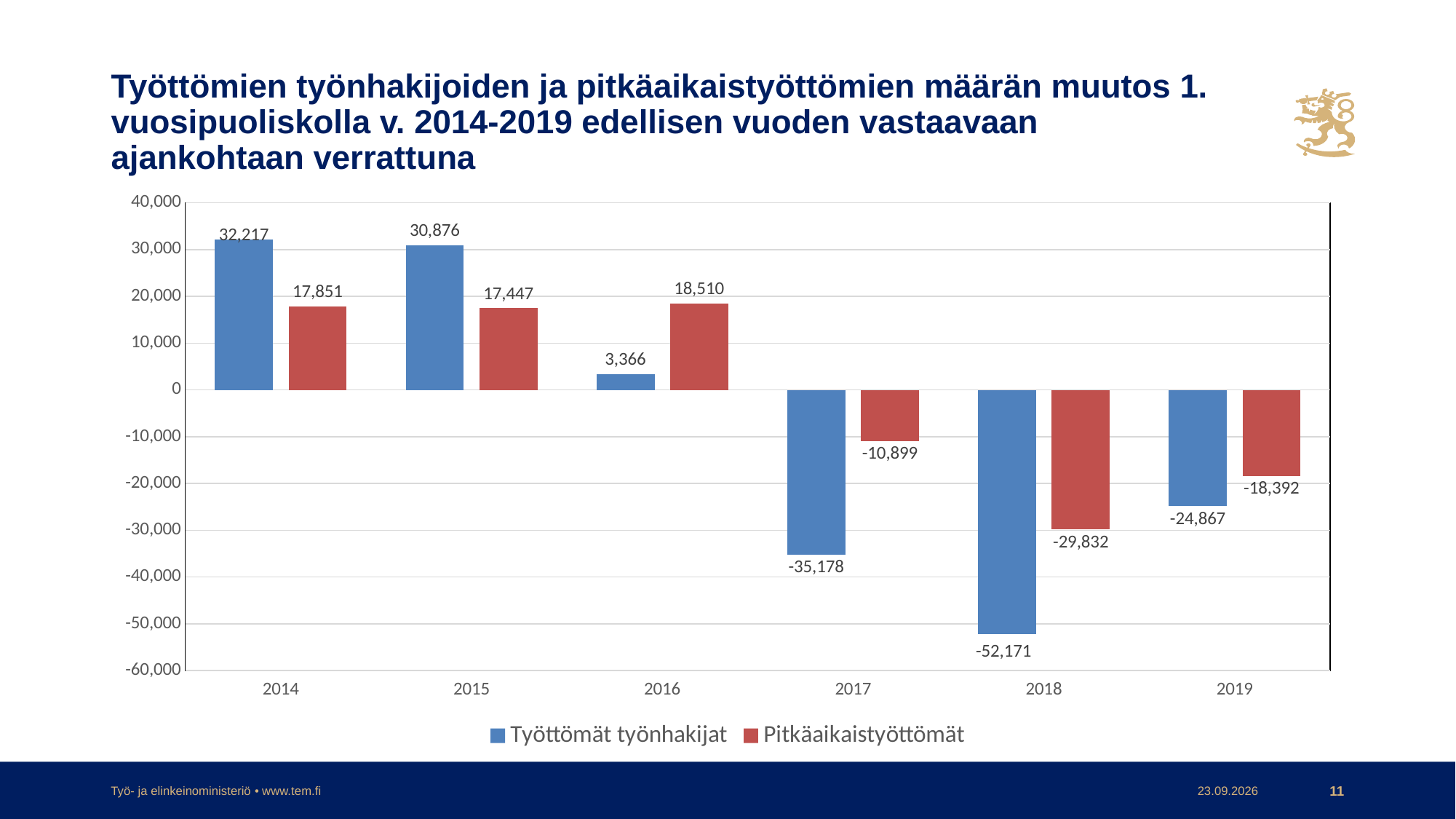
How many years are shown on the x axis? 6 In which year is the value for Pitkäaikaistyöttömät lowest? 2018 What kind of chart is shown on the slide? Bar chart In which year is the value for Työttömät työnhakijat highest? 2014 What is the value for Pitkäaikaistyöttömät in 2019? -18,392 How many series does the legend list? 2 What is the value for Työttömät työnhakijat in 2014? 32,217 What is the value for Työttömät työnhakijat in 2018? -52,171 What is the difference between the Työttömät työnhakijat value and the Pitkäaikaistyöttömät value in 2015? 13,429 Which colour represents Pitkäaikaistyöttömät in the legend? Red Which is larger in 2016, the value for Työttömät työnhakijat or the value for Pitkäaikaistyöttömät? Pitkäaikaistyöttömät What is the value for Pitkäaikaistyöttömät in 2016? 18,510